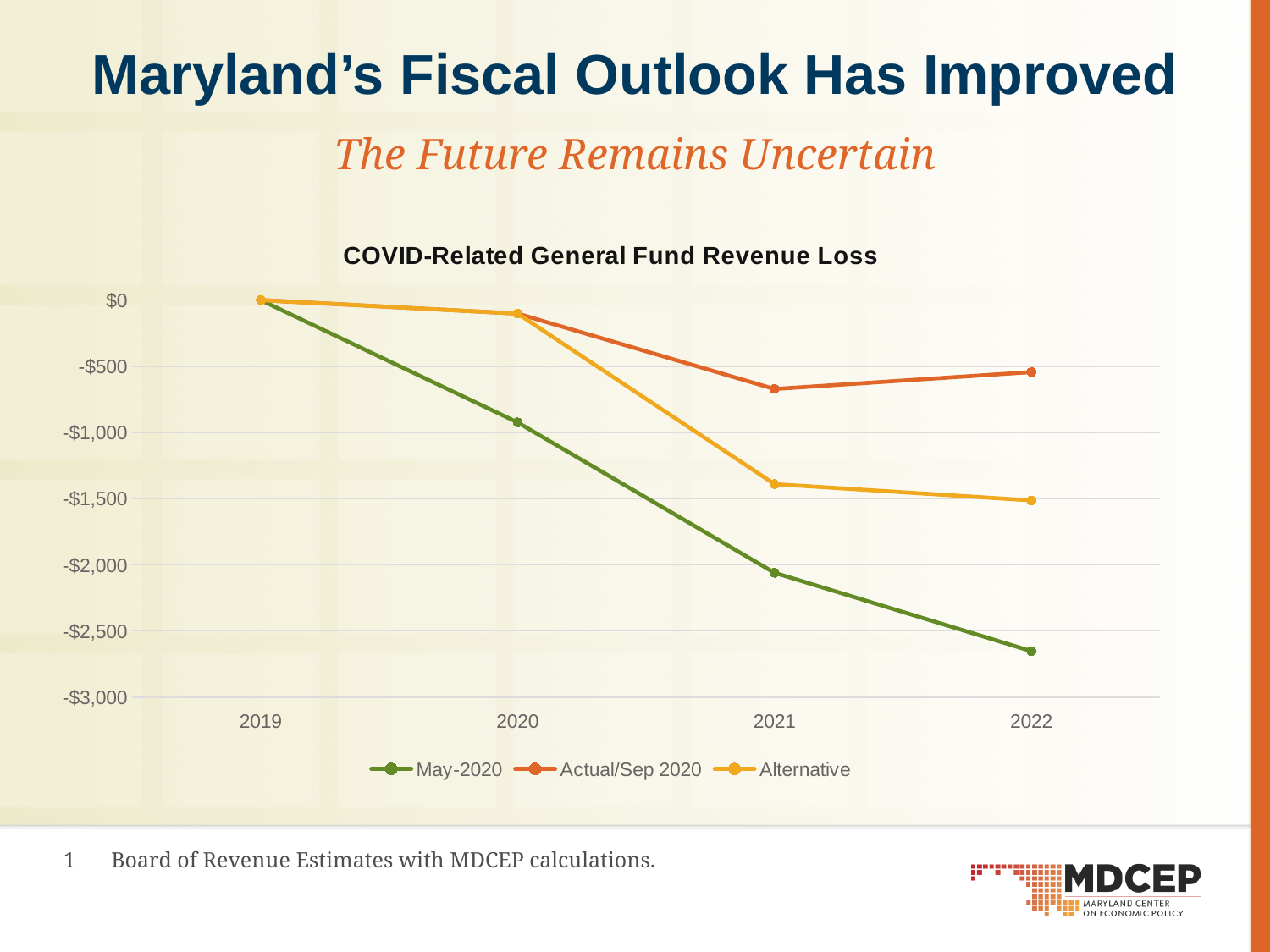
How many series does the legend list? 3 Which series has the lowest value in 2022? May-2020 What is the title of the chart? COVID-Related General Fund Revenue Loss What kind of chart is shown on the slide? line chart In 2021, which is larger: the value for Actual/Sep 2020 or the value for May-2020? Actual/Sep 2020 What is the value for the May-2020 series in 2019? $0 Does the May-2020 series rise or fall from 2019 to 2022? fall Is the value for May-2020 in 2022 greater or less than -$2,500? less Is the value for Actual/Sep 2020 in 2021 greater or less than -$500? less How many years are shown on the x axis? 4 Which series has the highest value in 2021? Actual/Sep 2020 Is the value for Alternative in 2021 greater or less than -$1,500? greater